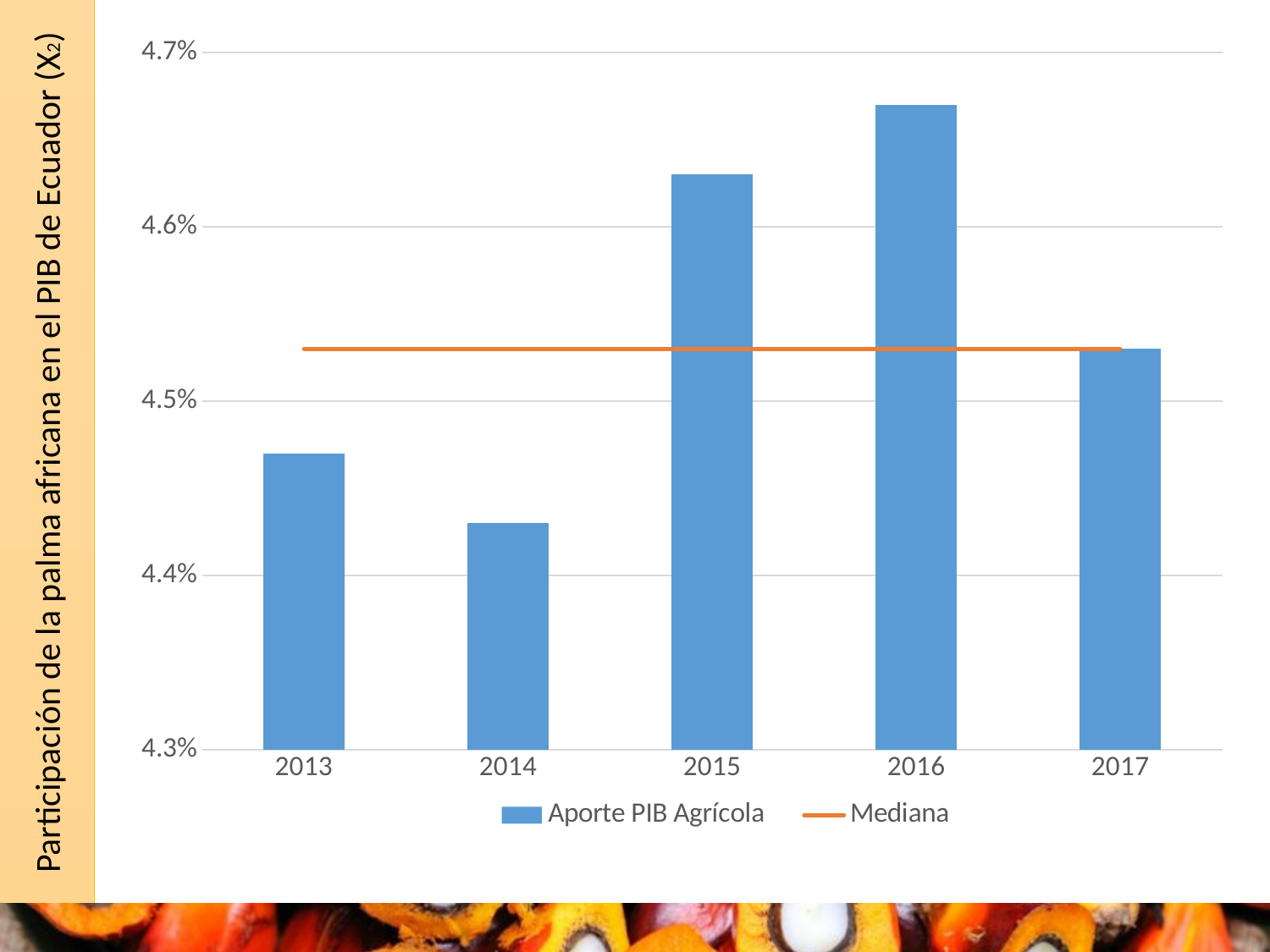
How many series does the chart legend list? 2 Is the value for Aporte PIB Agrícola in 2017 greater or less than 4.5%? greater Which is larger, the Aporte PIB Agrícola value for 2014 or for 2017? 2017 What is the name of the series drawn as an orange horizontal line? Mediana Is the value for Aporte PIB Agrícola in 2013 greater or less than 4.5%? less Which year has the highest value for Aporte PIB Agrícola? 2016 Which year has the lowest value for Aporte PIB Agrícola? 2014 What kind of chart is used to show the Aporte PIB Agrícola values? Bar chart Is the value for Aporte PIB Agrícola in 2015 greater or less than 4.6%? greater How many years are shown on the x axis of the chart? 5 Which is larger, the Aporte PIB Agrícola value for 2013 or for 2015? 2015